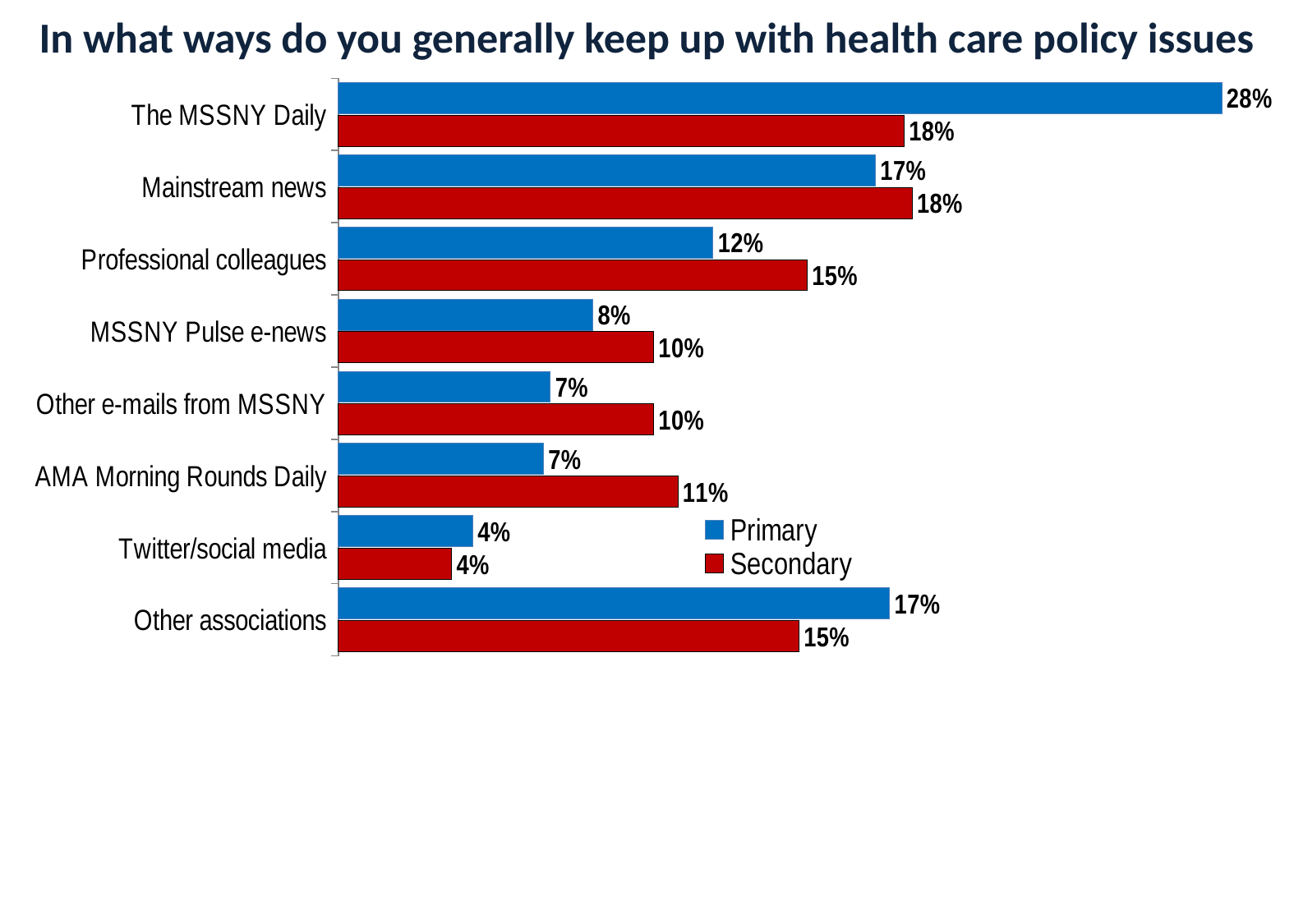
How many series does the legend list? 2 Which is larger for Professional colleagues, the Primary value or the Secondary value? Secondary Which colour represents the Secondary series in the legend? Red How many categories are shown on the chart? 8 What is the difference between the Primary and Secondary values for The MSSNY Daily? 10% What is the Secondary value for AMA Morning Rounds Daily? 11% Which category has the lowest Secondary value? Twitter/social media What is the Primary value for The MSSNY Daily? 28% What is the title of the chart? In what ways do you generally keep up with health care policy issues Which category has the highest Primary value? The MSSNY Daily What kind of chart is shown on the slide? Bar chart What is the Secondary value for Professional colleagues? 15%